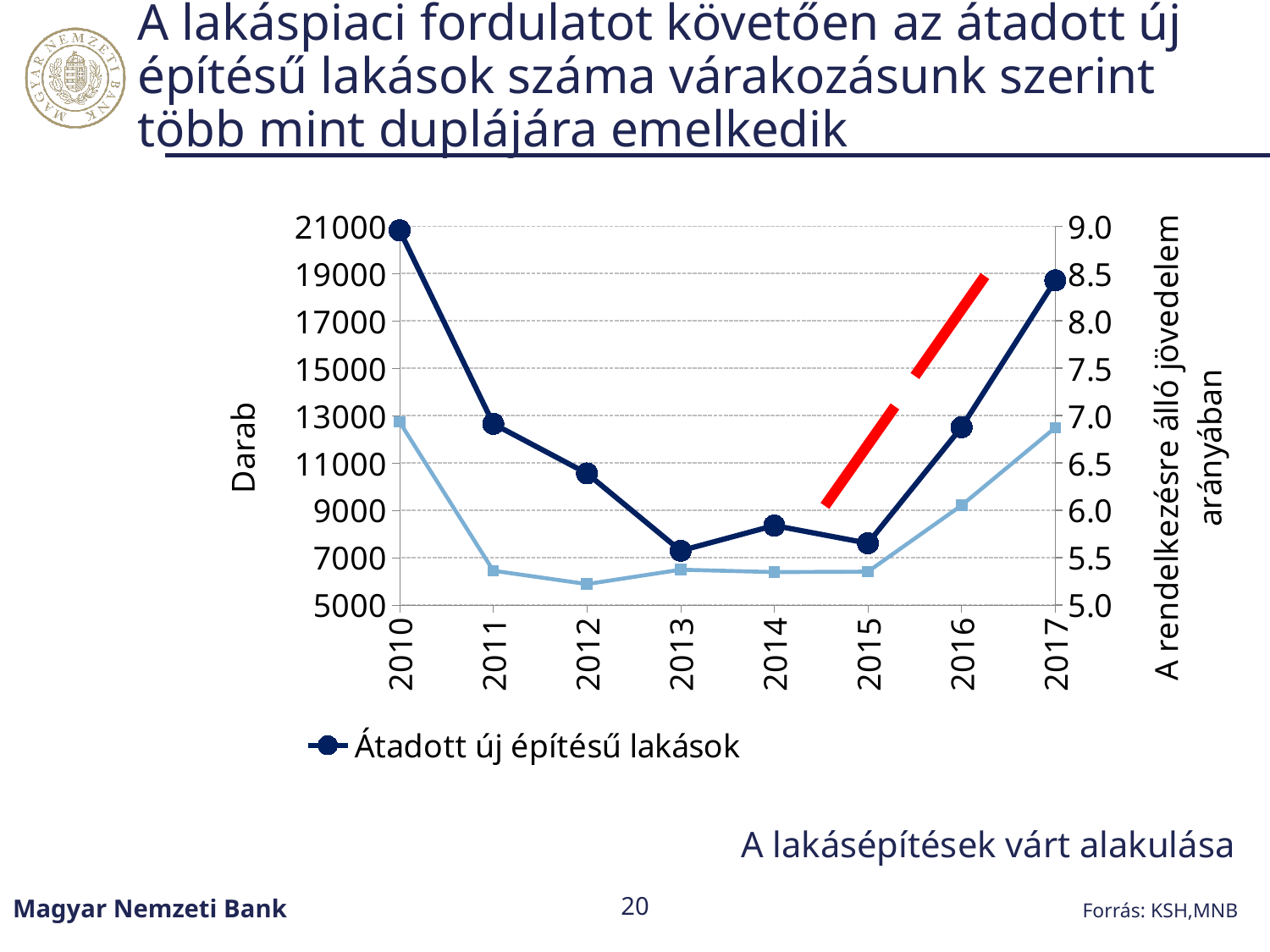
Is the value of 'Átadott új építésű lakások' in 2015 greater or less than 9000? less Is the value of 'Átadott új építésű lakások' in 2017 greater or less than 17000? greater What kind of chart is shown on the slide? line chart Is the value of 'Átadott új építésű lakások' in 2013 greater or less than 9000? less In which year is the value of 'Átadott új építésű lakások' highest? 2010 Does the 'Átadott új építésű lakások' series rise or fall from 2015 to 2017? rise How many years are shown on the x axis of the chart? 8 Which year has the larger value of 'Átadott új építésű lakások', 2010 or 2017? 2010 What is the label of the left vertical axis of the chart? Darab Which year has the larger value of 'Átadott új építésű lakások', 2013 or 2014? 2014